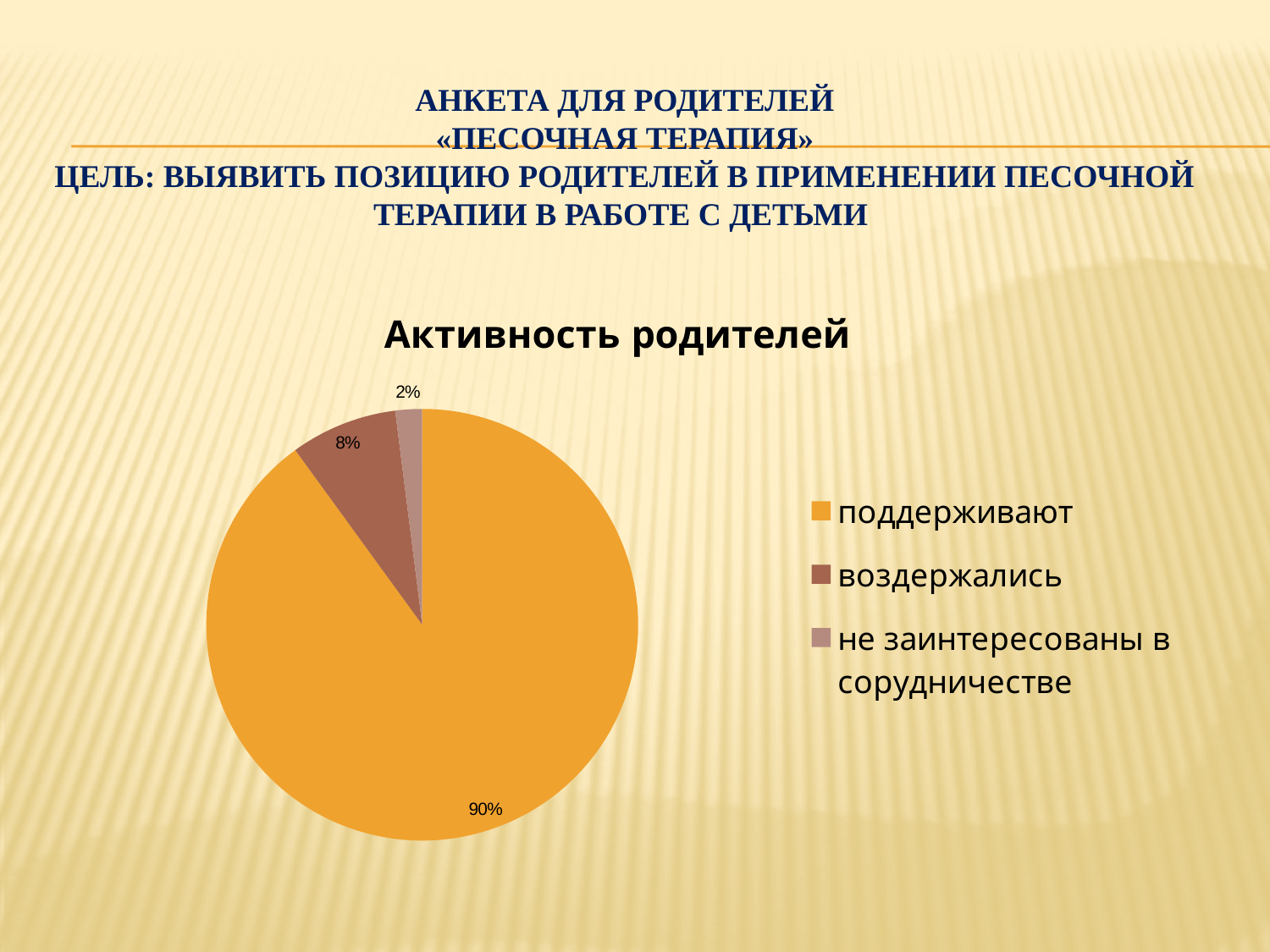
Which category has the largest slice of the pie? поддерживают Which category has the smallest slice of the pie? не заинтересованы в сорудничестве What is the title of the chart? Активность родителей What share of the pie is labelled "поддерживают"? 90% What kind of chart is shown on the slide? pie chart What share of the pie is labelled "воздержались"? 8% What colour is the slice for "поддерживают"? orange What is the difference between the "поддерживают" and "воздержались" shares? 82% How many entries does the legend list? 3 Which is larger, the share for "воздержались" or for "не заинтересованы в сорудничестве"? воздержались How many slices does the pie chart have? 3 What share of the pie is labelled "не заинтересованы в сорудничестве"? 2%